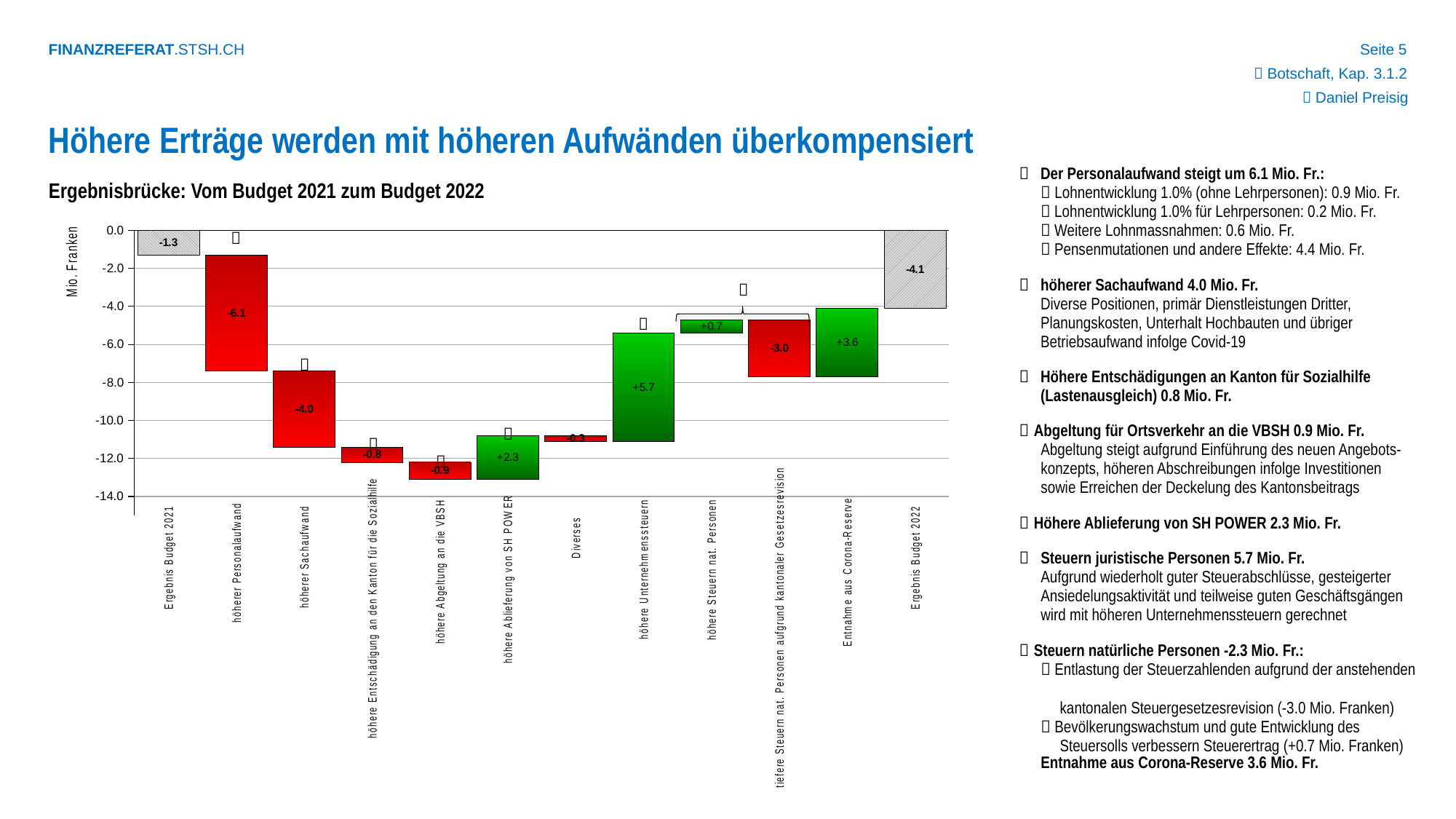
What is the value shown for 'höherer Personalaufwand'? -6.1 Which category has the largest positive value? höhere Unternehmenssteuern How many categories are shown on the x axis of the chart? 12 Which is larger in magnitude: the value for 'höhere Ablieferung von SH POWER' or the value for 'Entnahme aus Corona-Reserve'? Entnahme aus Corona-Reserve What type of chart is shown on the slide? Bar chart (waterfall) What is the value shown for 'Ergebnis Budget 2021'? -1.3 What is the value shown for 'höhere Unternehmenssteuern'? +5.7 What is the value shown for 'Ergebnis Budget 2022'? -4.1 Which category has the largest negative value? höherer Personalaufwand What is the value shown for 'Entnahme aus Corona-Reserve'? +3.6 What is the difference between the values for 'höherer Personalaufwand' (-6.1) and 'höherer Sachaufwand' (-4.0)? 2.1 What is the label of the vertical axis of the chart? Mio. Franken